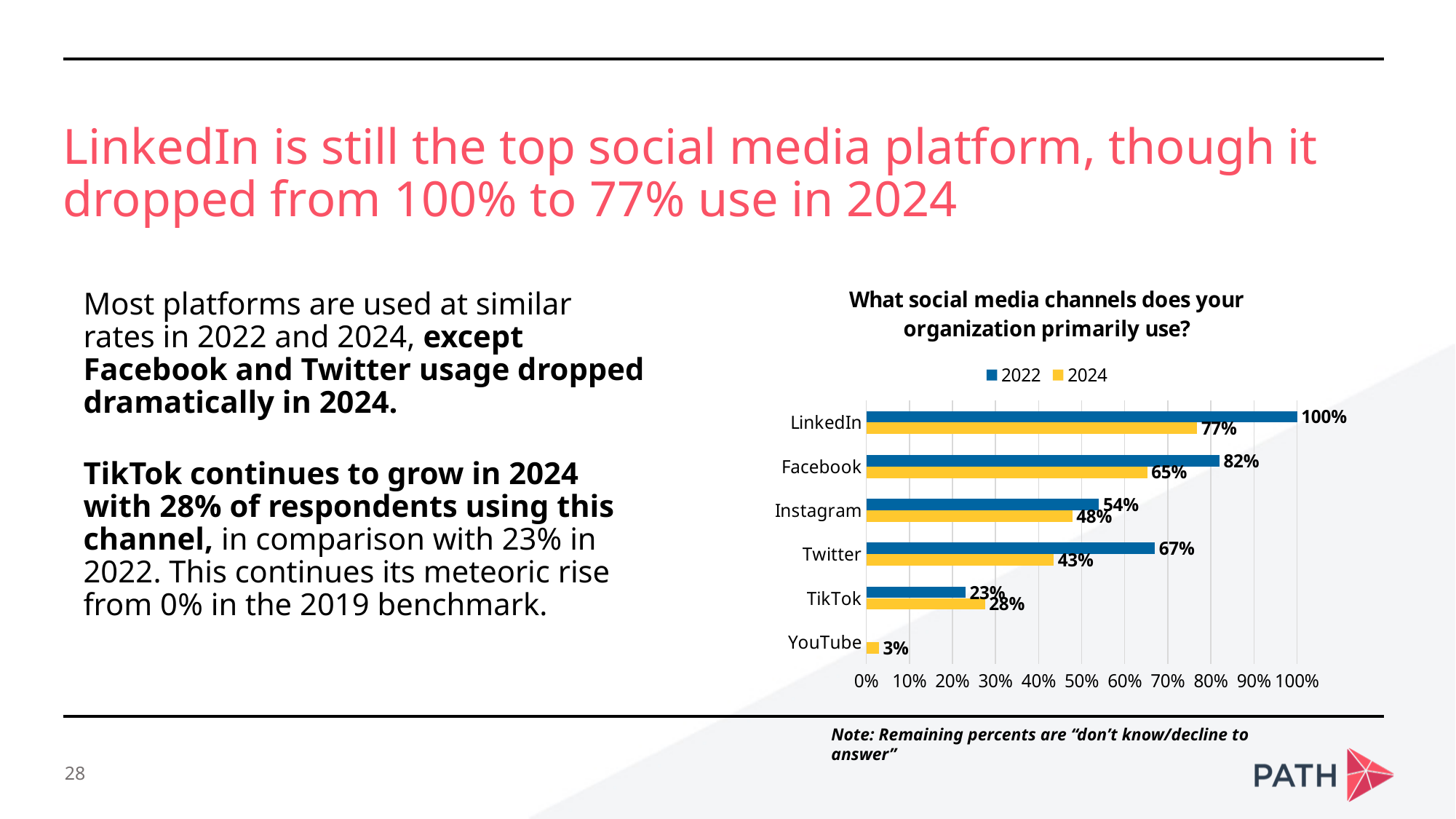
What kind of chart is shown? Bar chart What is the difference between the 2022 and 2024 values for Twitter? 24% What is the 2022 value for Twitter? 67% What is the 2022 value for LinkedIn? 100% How many series does the legend list? 2 Which platform has the highest 2024 value? LinkedIn How many platforms are listed on the chart? 6 Which is larger for TikTok, the 2022 value or the 2024 value? 2024 What is the title of the chart? What social media channels does your organization primarily use? What is the 2024 value for TikTok? 28% What is the 2024 value for Facebook? 65% Which platform has the lowest 2024 value? YouTube